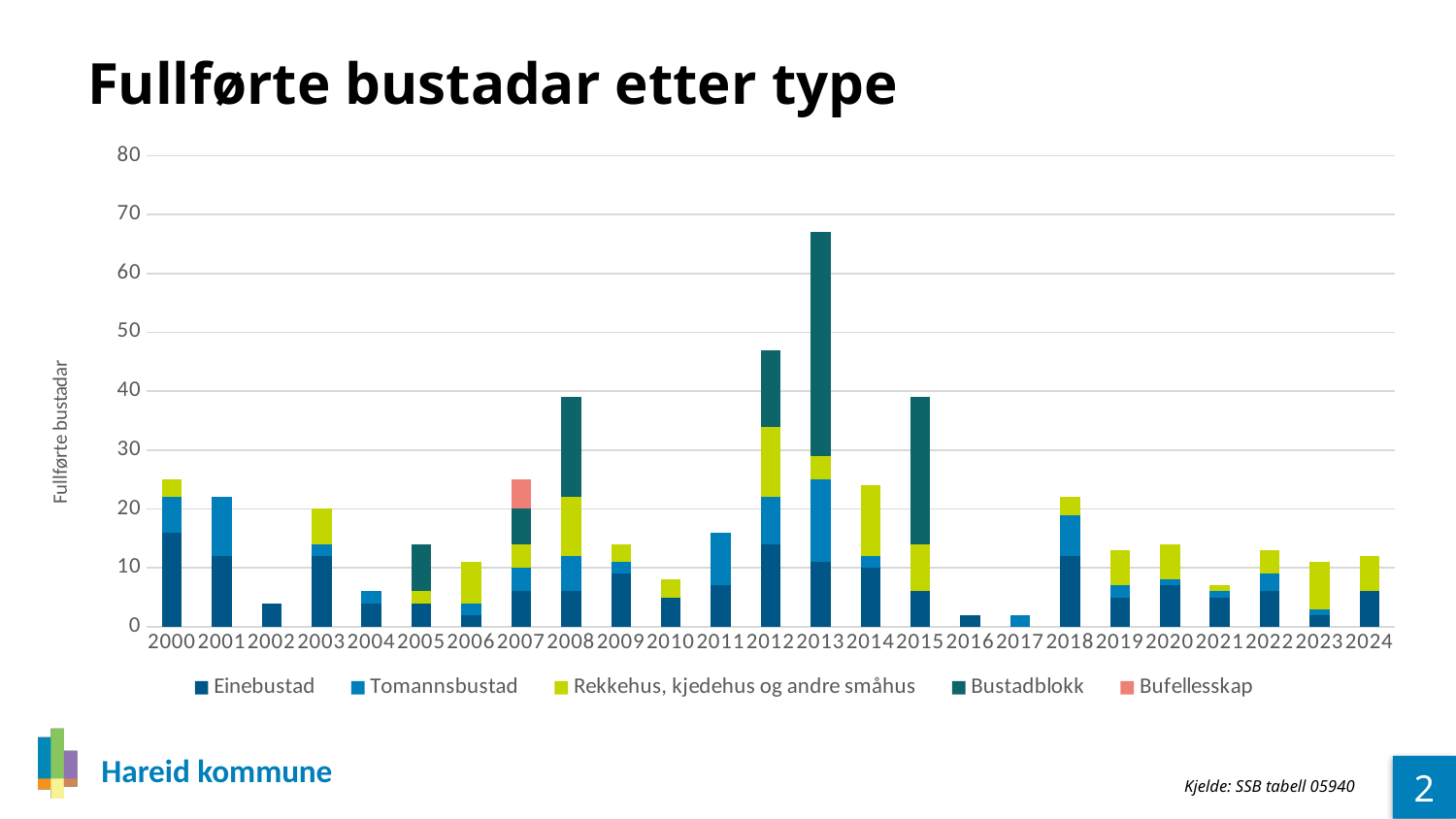
Which year has the larger total, 2012 or 2008? 2012 Is the total for 2012 greater or less than 40? greater Is the total for 2002 greater or less than 10? less What is the title of the chart? Fullførte bustadar etter type Is the total for 2011 greater or less than 20? less How many years are shown along the x axis? 25 Which year has the highest total of completed dwellings? 2013 How many series does the legend list? 5 Which year has the larger total, 2005 or 2004? 2005 Which series is shown in pink/red in the legend? Bufellesskap What kind of chart is shown on the slide? Stacked bar chart